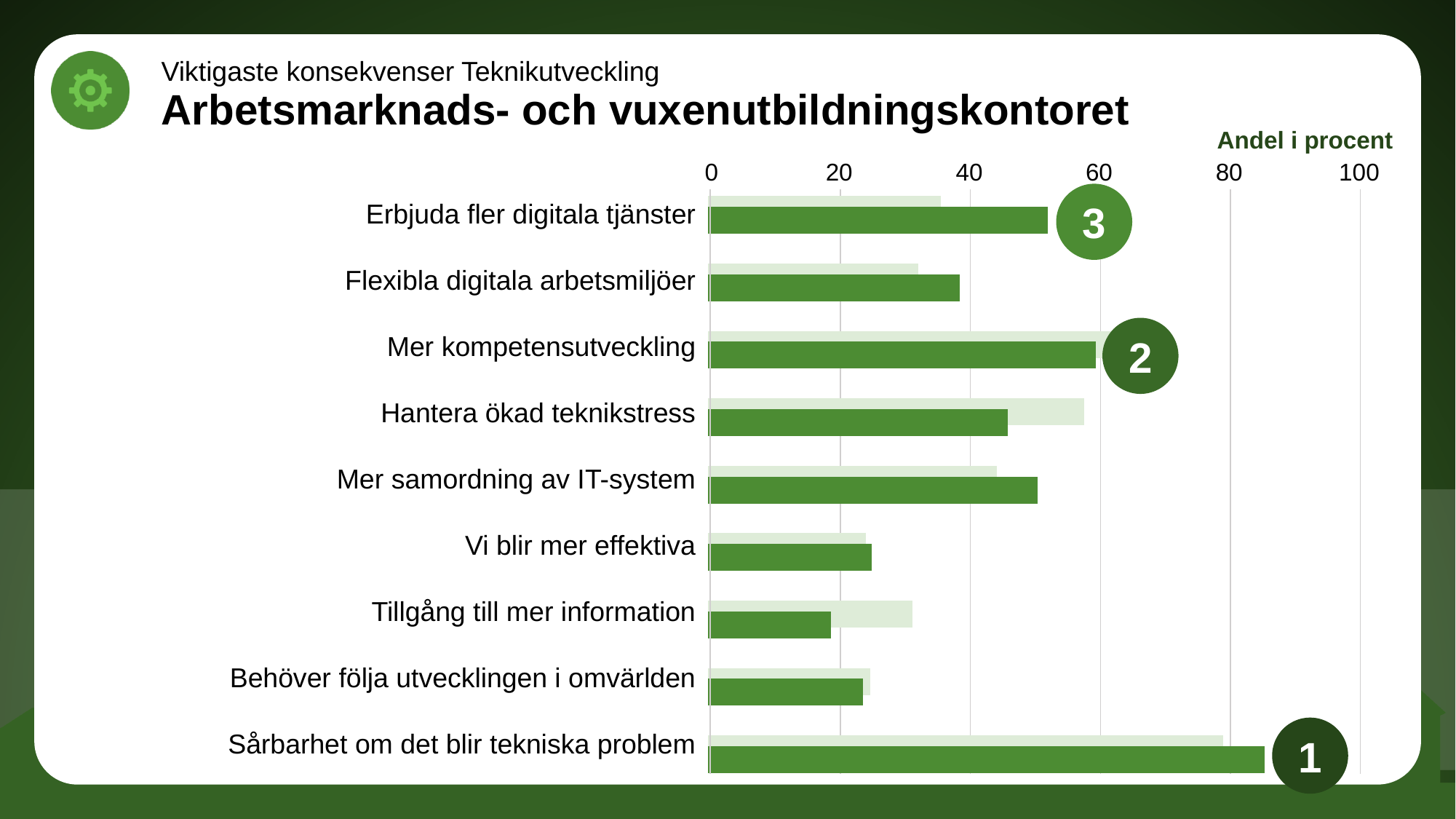
Is the dark green value for Flexibla digitala arbetsmiljöer greater or less than 20? greater Is the dark green value for Erbjuda fler digitala tjänster greater or less than 40? greater How many categories are listed on the chart? 9 Which category has the longest dark green bar? Sårbarhet om det blir tekniska problem Is the dark green value for Vi blir mer effektiva greater or less than 40? less What is the label shown above the horizontal axis of the chart? Andel i procent Which category is marked with the circle numbered 1? Sårbarhet om det blir tekniska problem Which category has the shortest dark green bar? Tillgång till mer information Which has the larger dark green value, Erbjuda fler digitala tjänster or Flexibla digitala arbetsmiljöer? Erbjuda fler digitala tjänster What kind of chart is shown on the slide? bar chart